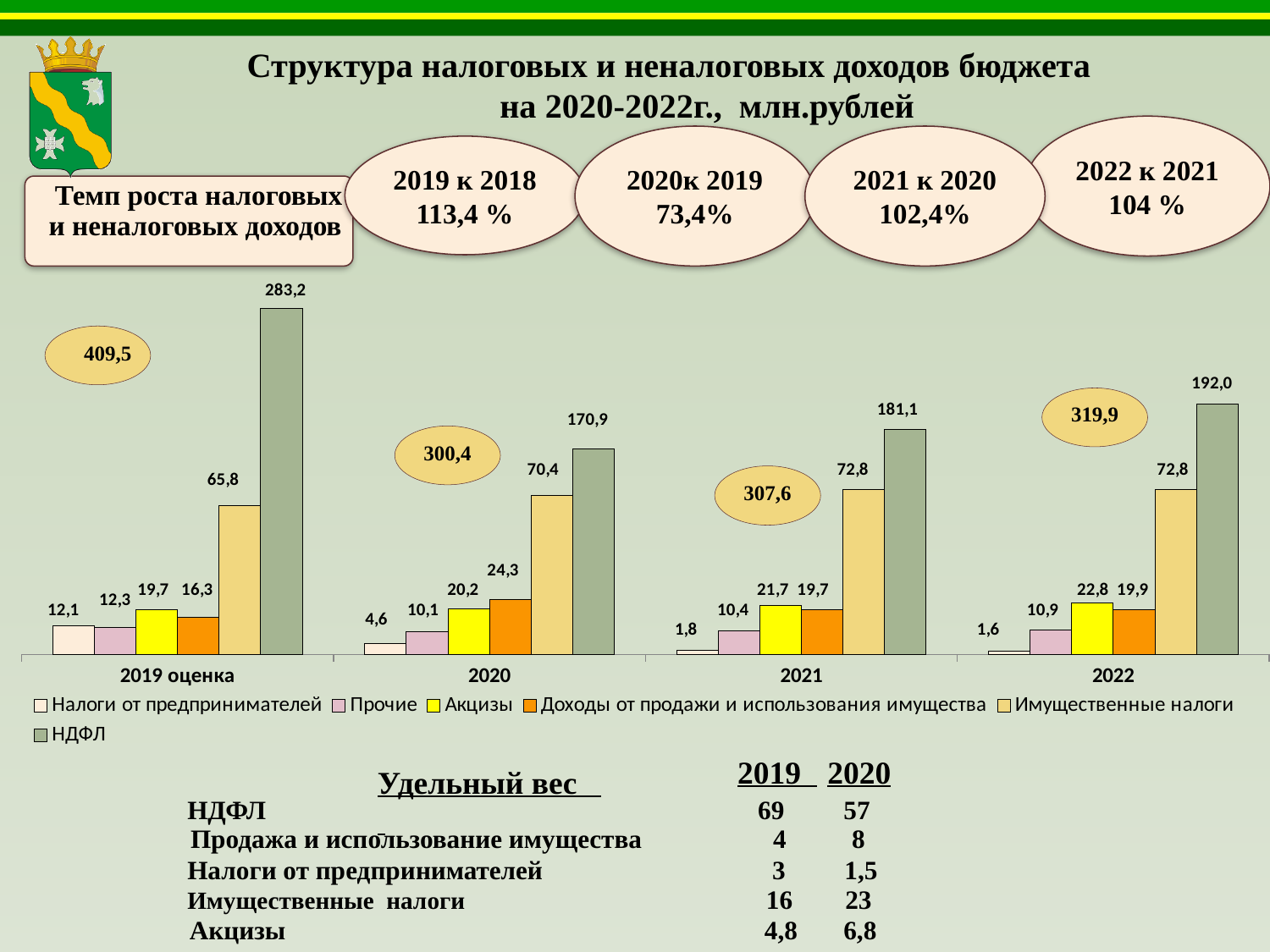
How many categories are shown on the x axis of the chart? 4 How many series does the chart legend list? 6 In which category is the Налоги от предпринимателей value lowest? 2022 Which is larger: Доходы от продажи и использования имущества for 2020 or for 2021? 2020 In which category is the НДФЛ value highest? 2019 оценка What kind of chart is shown on the slide? bar chart What is the value of Имущественные налоги for 2020? 70,4 What is the value of Акцизы for 2022? 22,8 What is the difference between the НДФЛ values for 2022 and 2021? 10,9 What is the value of НДФЛ for 2019 оценка? 283,2 What is the value of Налоги от предпринимателей for 2021? 1,8 Do the Акцизы values rise or fall from 2019 оценка to 2022? rise